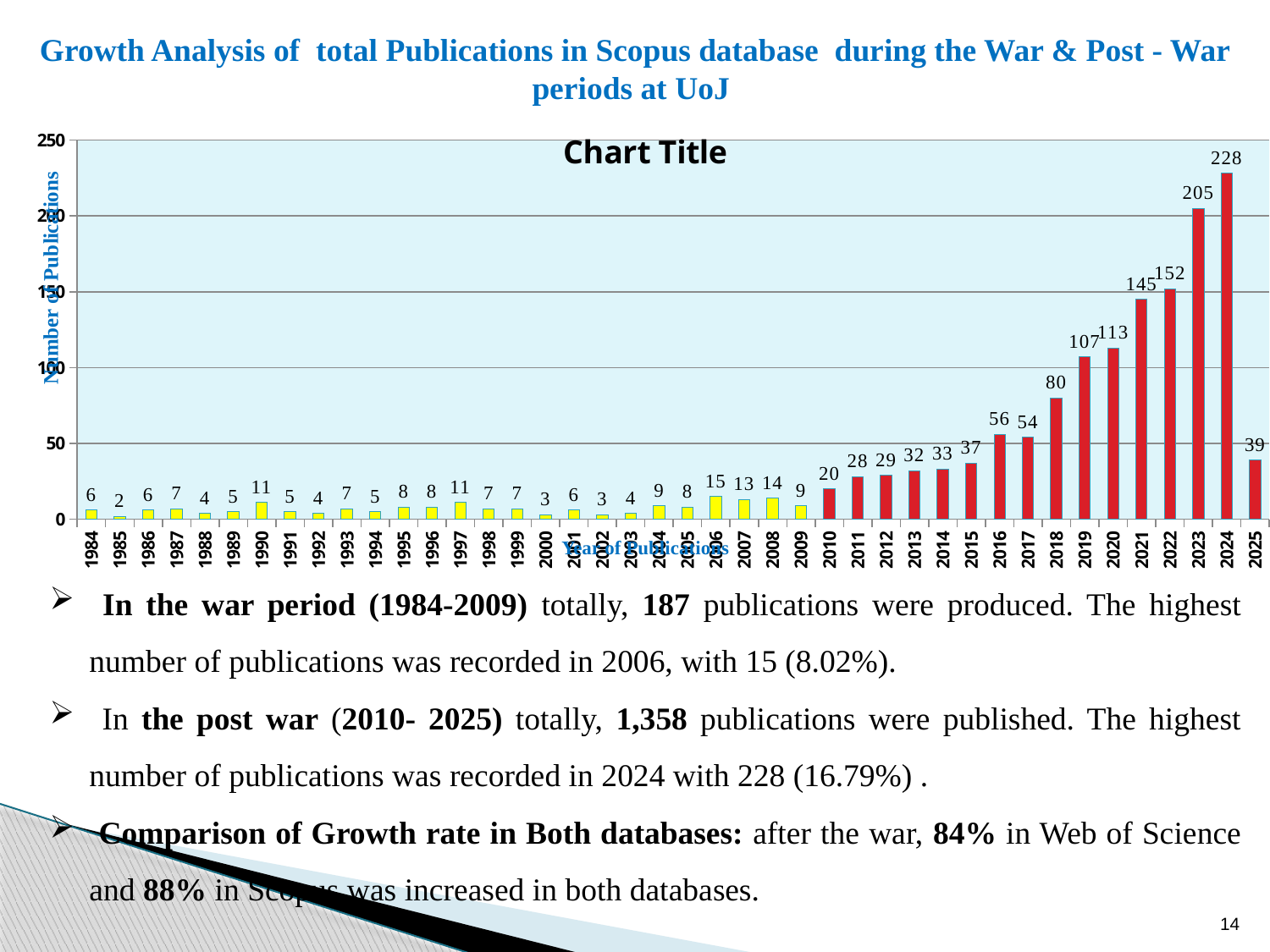
Which year has more publications, 2016 or 2017? 2016 How many years are shown on the x axis of the chart? 42 What is the number of publications shown for 2024? 228 What is the number of publications shown for 2006? 15 What is the number of publications shown for 2025? 39 Is the value for 2021 greater or less than 100? greater What is the number of publications shown for 2019? 107 What kind of chart is shown on the slide? Bar chart What is the label on the vertical axis of the chart? Number of Publications Which year has the lowest number of publications? 1985 Which year has the highest number of publications? 2024 What is the difference between the number of publications in 2024 and in 2023? 23